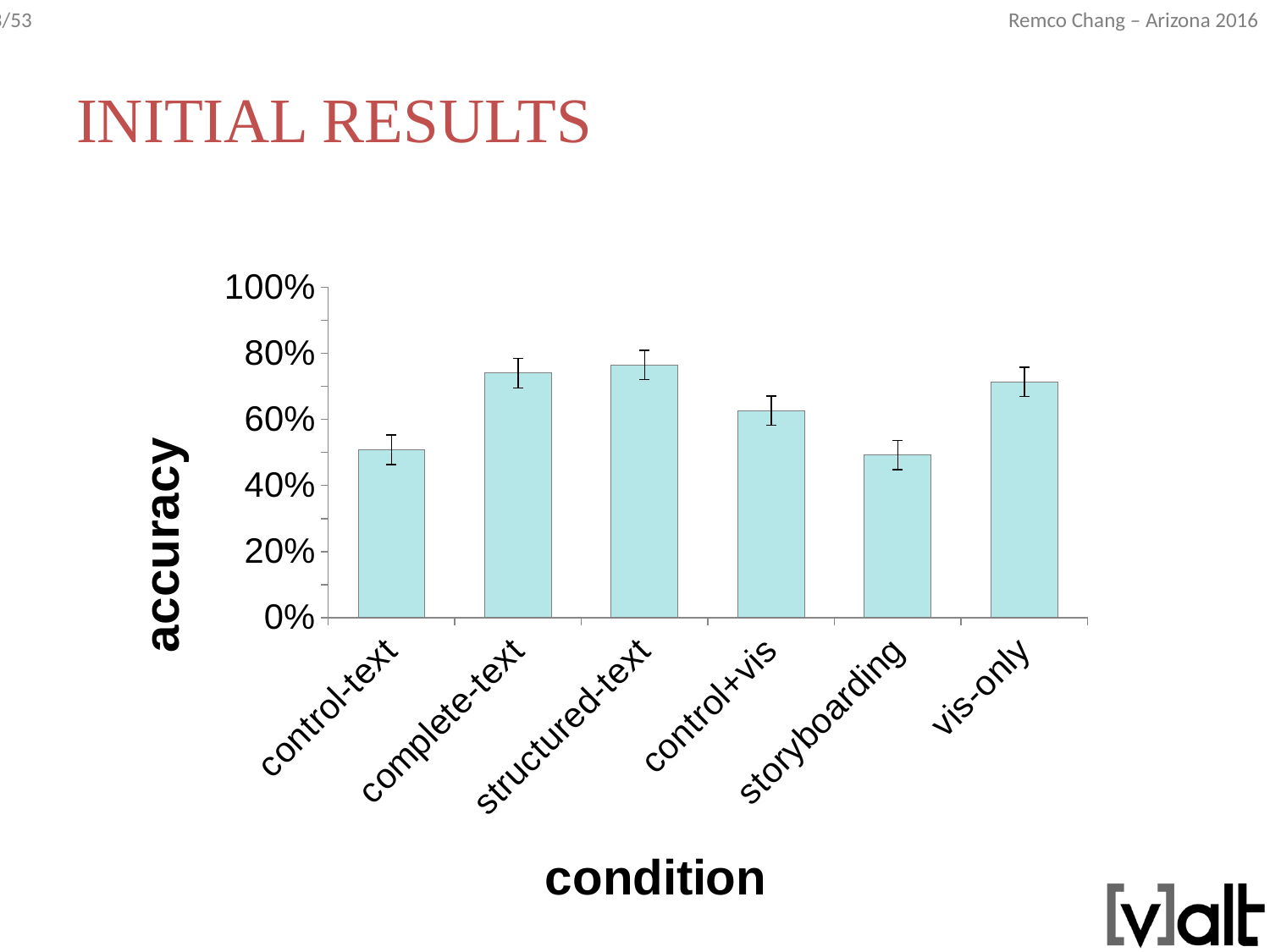
What is the label on the y axis of the chart? accuracy What is the label on the x axis of the chart? condition Is the accuracy for complete-text greater or less than 60%? greater Which condition has the higher accuracy, structured-text or control+vis? structured-text How many conditions are plotted on the x axis of the chart? 6 Which condition has the higher accuracy, complete-text or control-text? complete-text Which condition has the higher accuracy, vis-only or storyboarding? vis-only Is the accuracy for control-text greater or less than 60%? less Is the accuracy for structured-text greater or less than 80%? less What kind of chart is shown on the slide? bar chart